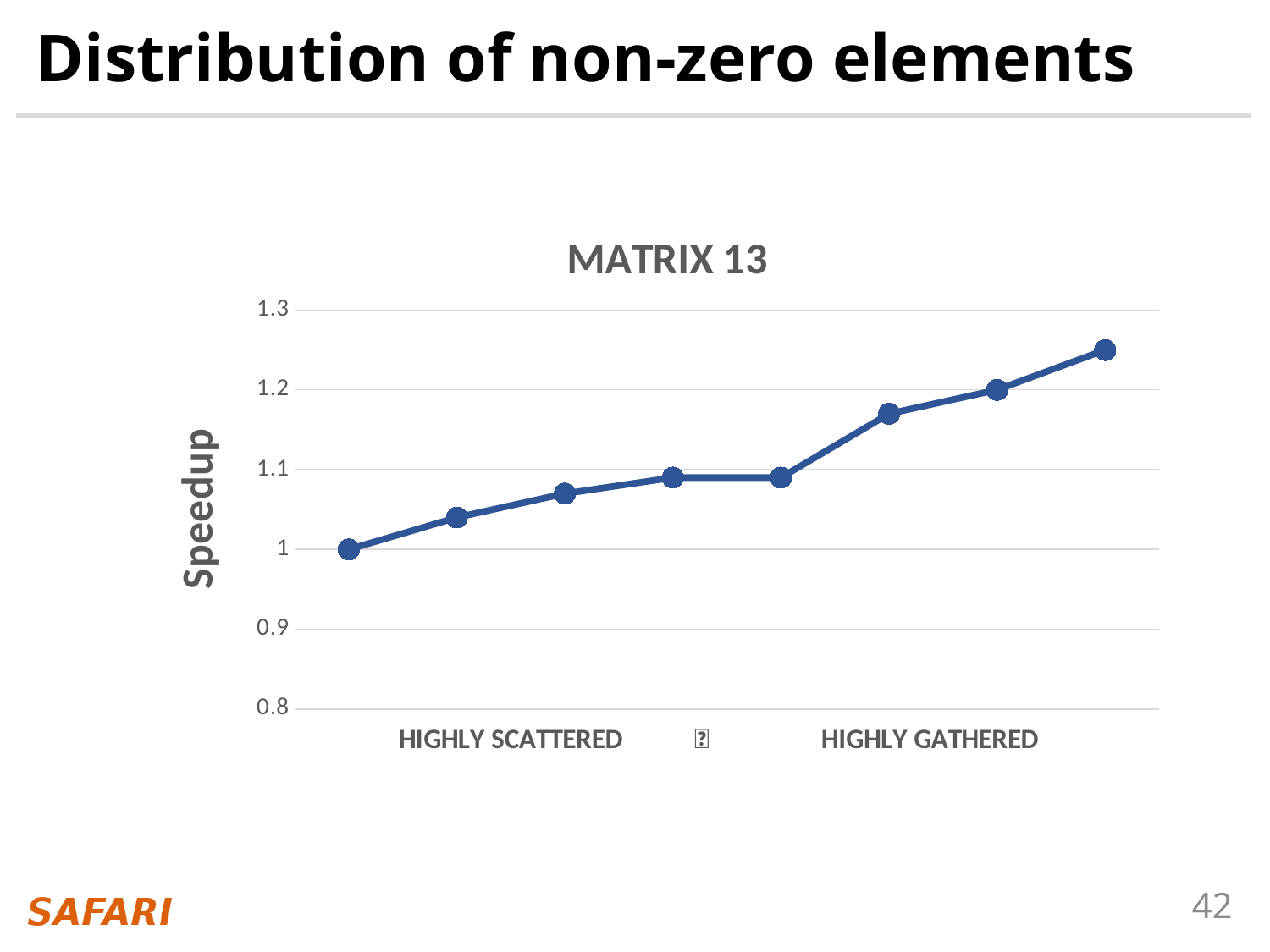
Which point has the lowest speedup on the chart? the leftmost (highly scattered) point What is the speedup value of the leftmost (highly scattered) point? 1 What is the label of the y axis? Speedup Which point has the highest speedup, the leftmost or the rightmost? the rightmost What kind of chart is shown on the slide? line chart What is the title of the chart? MATRIX 13 Is the speedup of the sixth point from the left greater or less than 1.1? greater Is the speedup of the second point from the left greater or less than 1.1? less Is the speedup of the rightmost (highly gathered) point greater or less than 1.2? greater Which has the larger speedup, the third point from the left or the sixth point from the left? the sixth point Do the speedup values rise or fall from left (highly scattered) to right (highly gathered)? rise How many data points are plotted on the line? 8